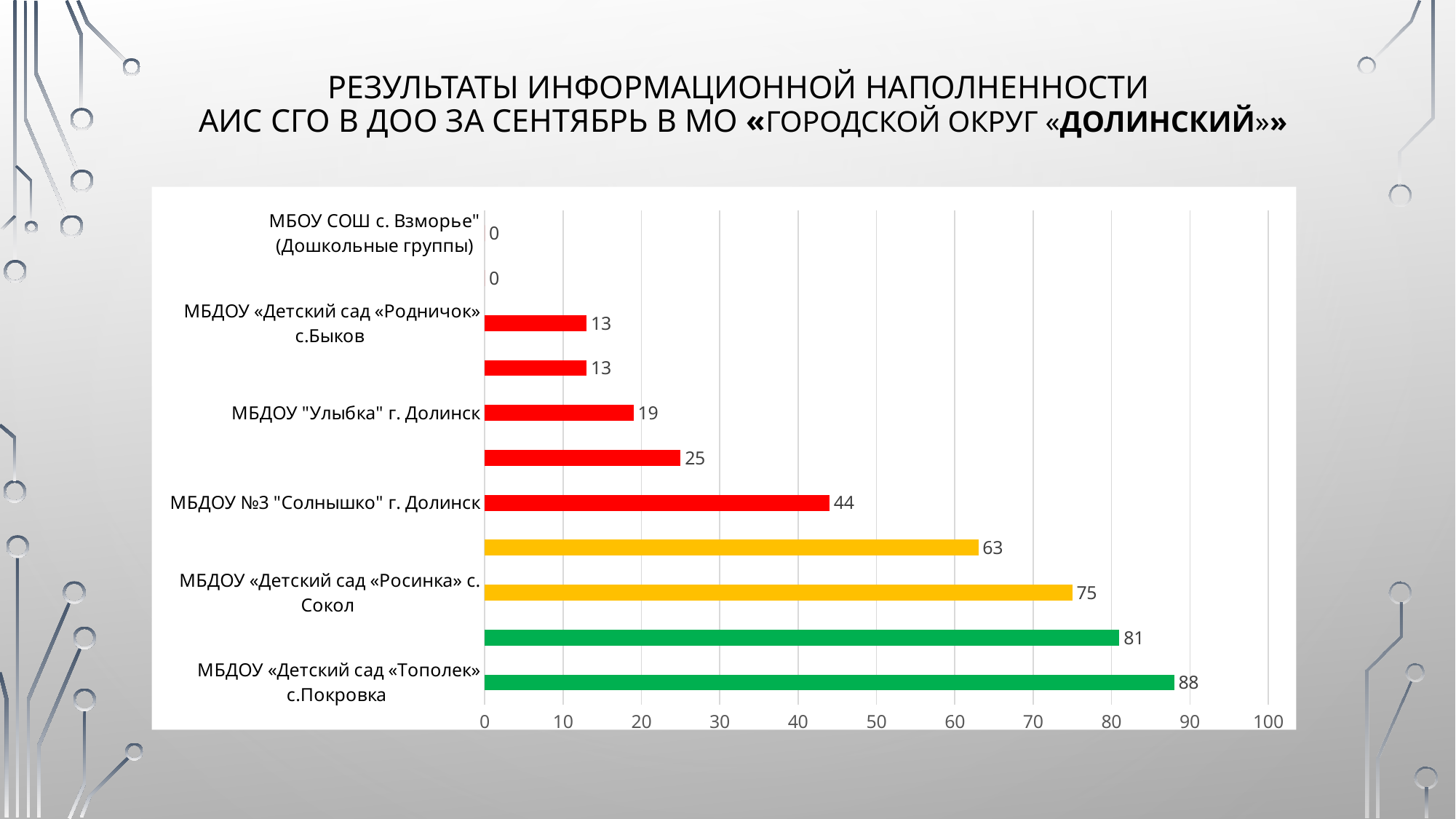
What is the value for МБОУ СОШ с. Взморье" (Дошкольные группы)? 0 What kind of chart is shown on the slide? bar chart What is the difference between the values for МБДОУ «Детский сад «Тополек» с.Покровка and МБДОУ «Детский сад «Росинка» с. Сокол? 13 What is the value for МБДОУ «Детский сад «Тополек» с.Покровка? 88 What is the value for МБДОУ №3 "Солнышко" г. Долинск? 44 Is the value for МБДОУ «Детский сад «Росинка» с. Сокол greater or less than 70? greater What is the value for МБДОУ «Детский сад «Росинка» с. Сокол? 75 What is the value for МБДОУ "Улыбка" г. Долинск? 19 Which is larger, the value for МБДОУ №3 "Солнышко" г. Долинск or the value for МБДОУ "Улыбка" г. Долинск? МБДОУ №3 "Солнышко" г. Долинск What is the value for МБДОУ «Детский сад «Родничок» с.Быков? 13 How many bars are plotted in the chart? 11 Which labelled organisation has the highest value? МБДОУ «Детский сад «Тополек» с.Покровка